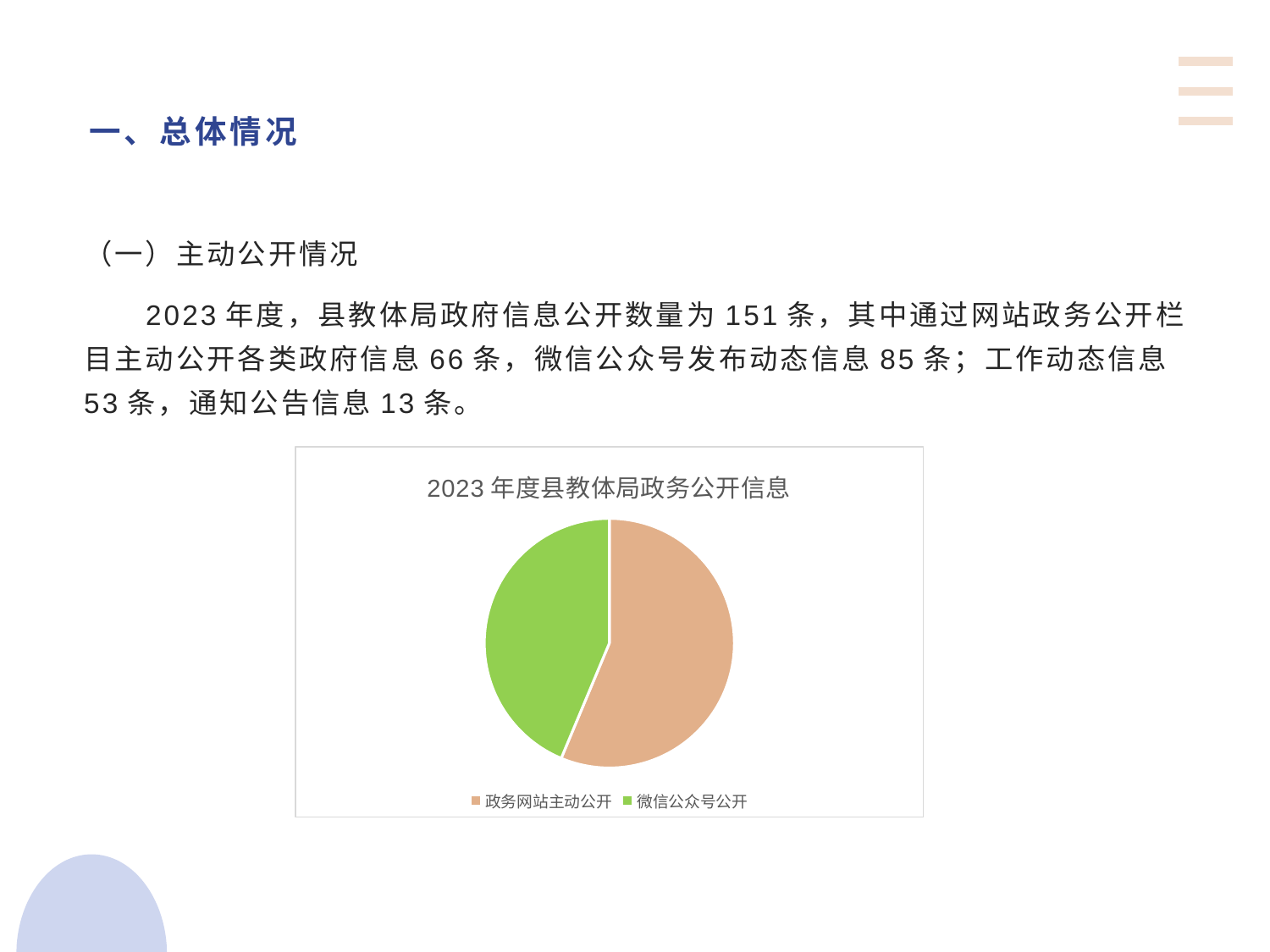
Which category has the largest slice of the pie? 政务网站主动公开 Does the 政务网站主动公开 slice take up more or less than half of the pie? More Which colour represents 微信公众号公开 in the pie chart? Green What is the title of the chart? 2023 年度县教体局政务公开信息 What kind of chart is shown on the slide? Pie chart How many entries does the chart legend list? 2 Which slice is larger, 政务网站主动公开 or 微信公众号公开? 政务网站主动公开 Which category has the smallest slice of the pie? 微信公众号公开 How many slices does the pie chart have? 2